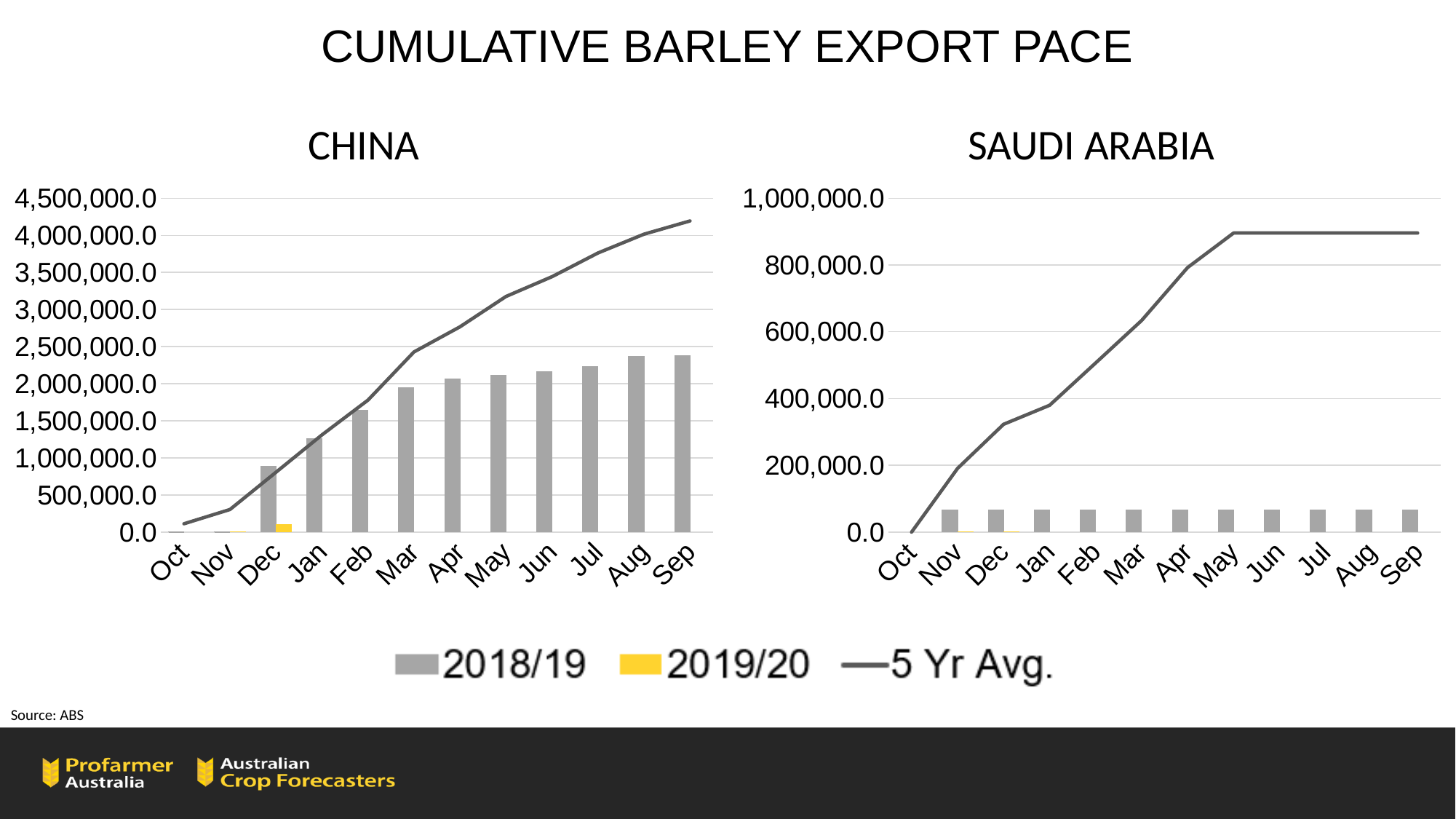
How many series does the legend list? 3 In the SAUDI ARABIA chart, does the 5 Yr Avg. line rise or fall from Oct to May? Rise In the CHINA chart, is the 5 Yr Avg. value for Sep greater or less than 4,000,000? greater In the SAUDI ARABIA chart, is the 2018/19 value for Sep greater or less than 200,000? less What kind of chart is the CHINA chart? A combined bar and line chart In the CHINA chart, which series is shown as a line? 5 Yr Avg. In the CHINA chart, is the 2018/19 value for Dec greater or less than 1,000,000? less How many months are shown on the x axis of the SAUDI ARABIA chart? 12 In the CHINA chart, which colour represents the 2019/20 series? Yellow In the CHINA chart, which is larger in Sep: the 5 Yr Avg. line or the 2018/19 bar? 5 Yr Avg.